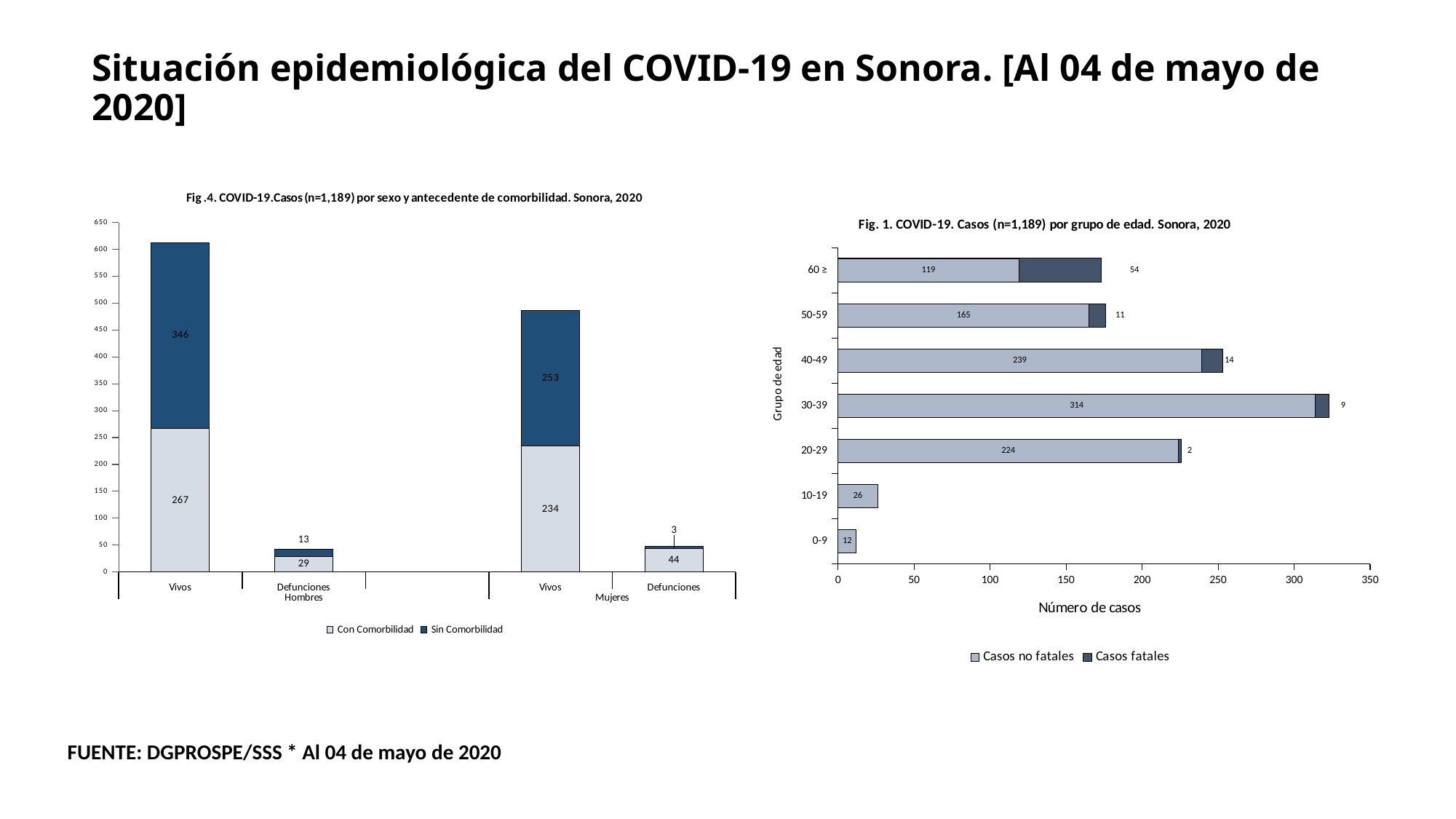
What kind of chart is the right chart (Fig. 1)? Stacked horizontal bar chart In the left chart (Fig. 4), what is the total of the stacked bar for Defunciones among Hombres? 42 In the right chart (Fig. 1), how many age groups are shown? 7 In the left chart (Fig. 4), what is the difference between the Con Comorbilidad values for Vivos among Hombres and Vivos among Mujeres? 33 In the right chart (Fig. 1), which age group has the lowest Casos no fatales value? 0-9 In the left chart (Fig. 4), is the total for Vivos among Hombres greater or less than 600? greater In the left chart (Fig. 4), what is the Con Comorbilidad value for Vivos among Hombres? 267 In the right chart (Fig. 1), which age group has the highest Casos fatales value? 60 ≥ In the right chart (Fig. 1), what is the Casos no fatales value for the 30-39 age group? 314 In the left chart (Fig. 4), how many series does the legend list? 2 In the left chart (Fig. 4), what is the Sin Comorbilidad value for Vivos among Mujeres? 253 In the right chart (Fig. 1), what is the total of the stacked bar for the 40-49 age group? 253